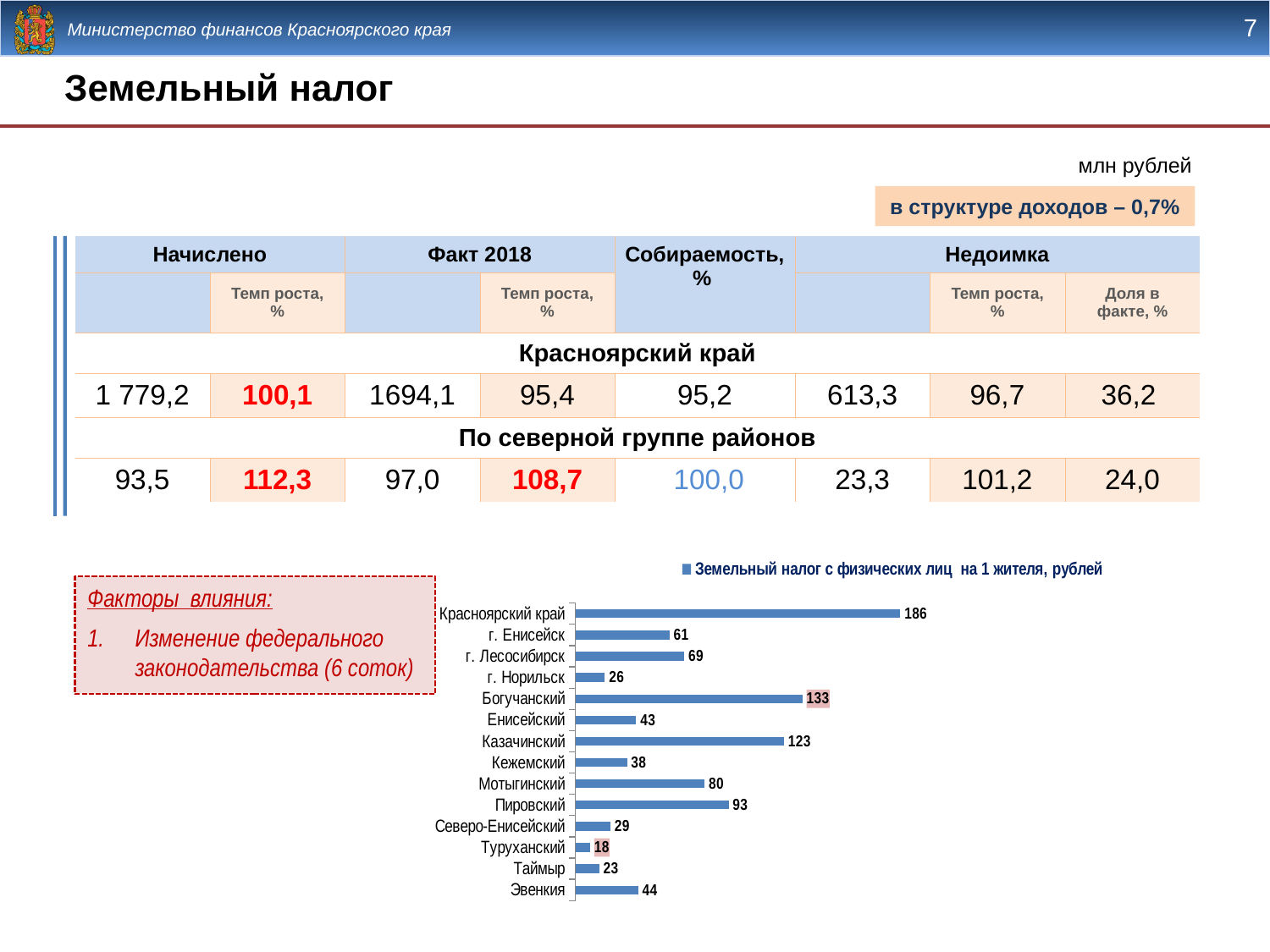
What is the value for Богучанский in the chart? 133 What is the difference between the values for Казачинский and Мотыгинский? 43 Which category has the highest value in the chart? Красноярский край What is the value for Красноярский край in the chart? 186 Which is larger, the value for г. Лесосибирск or the value for г. Енисейск? г. Лесосибирск What is the title of the chart? Земельный налог с физических лиц на 1 жителя, рублей What is the difference between the values for Красноярский край and Богучанский? 53 What kind of chart is shown on the slide? bar chart What is the value for Таймыр in the chart? 23 What is the value for Пировский in the chart? 93 Which category has the lowest value in the chart? Туруханский How many categories are shown in the chart? 14